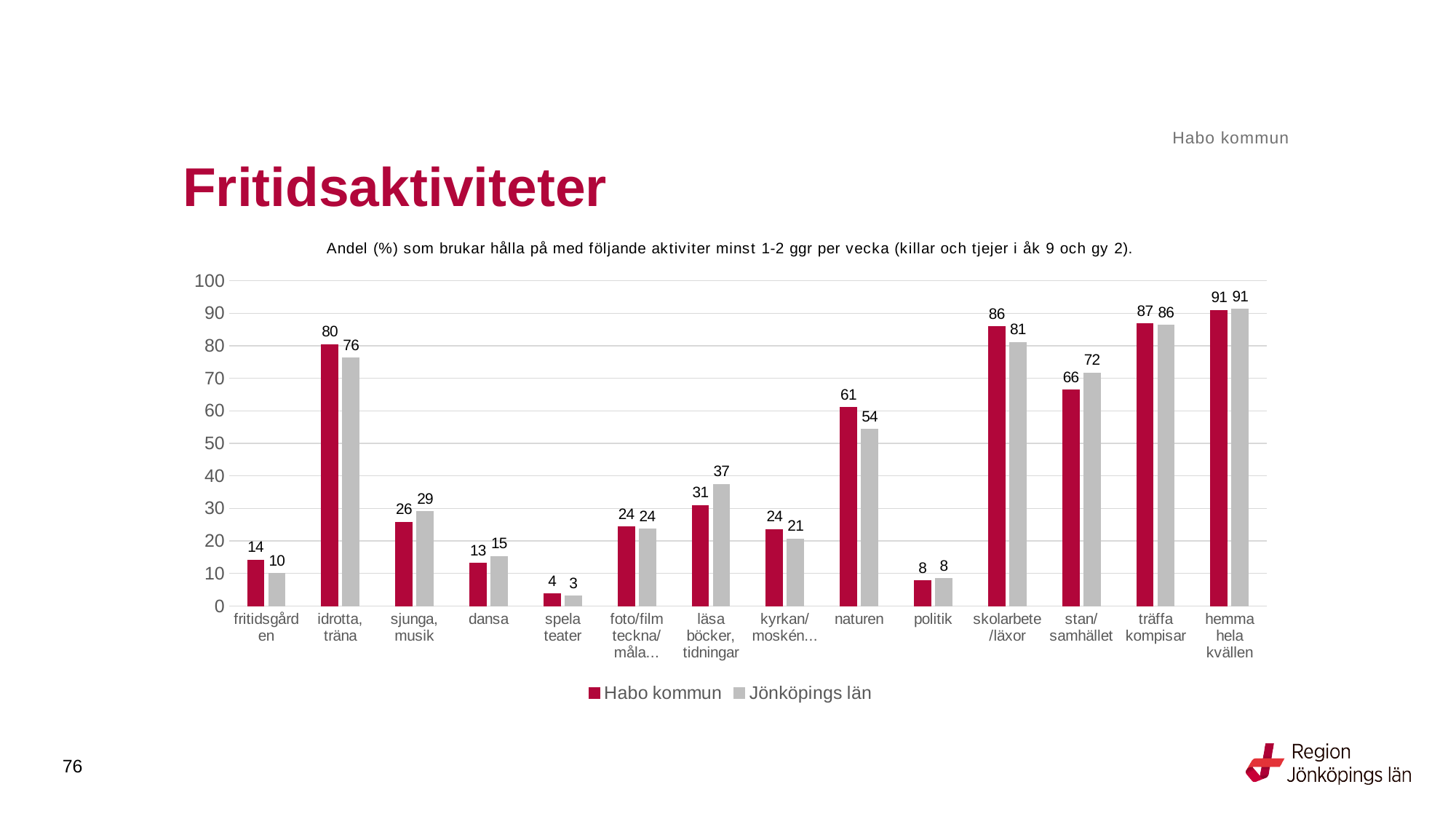
What kind of chart is shown on the slide? bar chart Which series is shown in red? Habo kommun What is the value for Habo kommun for naturen? 61 Which is larger for dansa: Habo kommun or Jönköpings län? Jönköpings län What is the difference between Habo kommun and Jönköpings län for naturen? 7 What is the difference between Habo kommun and Jönköpings län for stan/samhället? 6 How many series does the legend list? 2 Which category has the highest value for Habo kommun? hemma hela kvällen What is the value for Habo kommun for skolarbete/läxor? 86 What is the value for Jönköpings län for läsa böcker, tidningar? 37 Which category has the lowest value for Jönköpings län? spela teater How many categories are shown on the x axis? 14